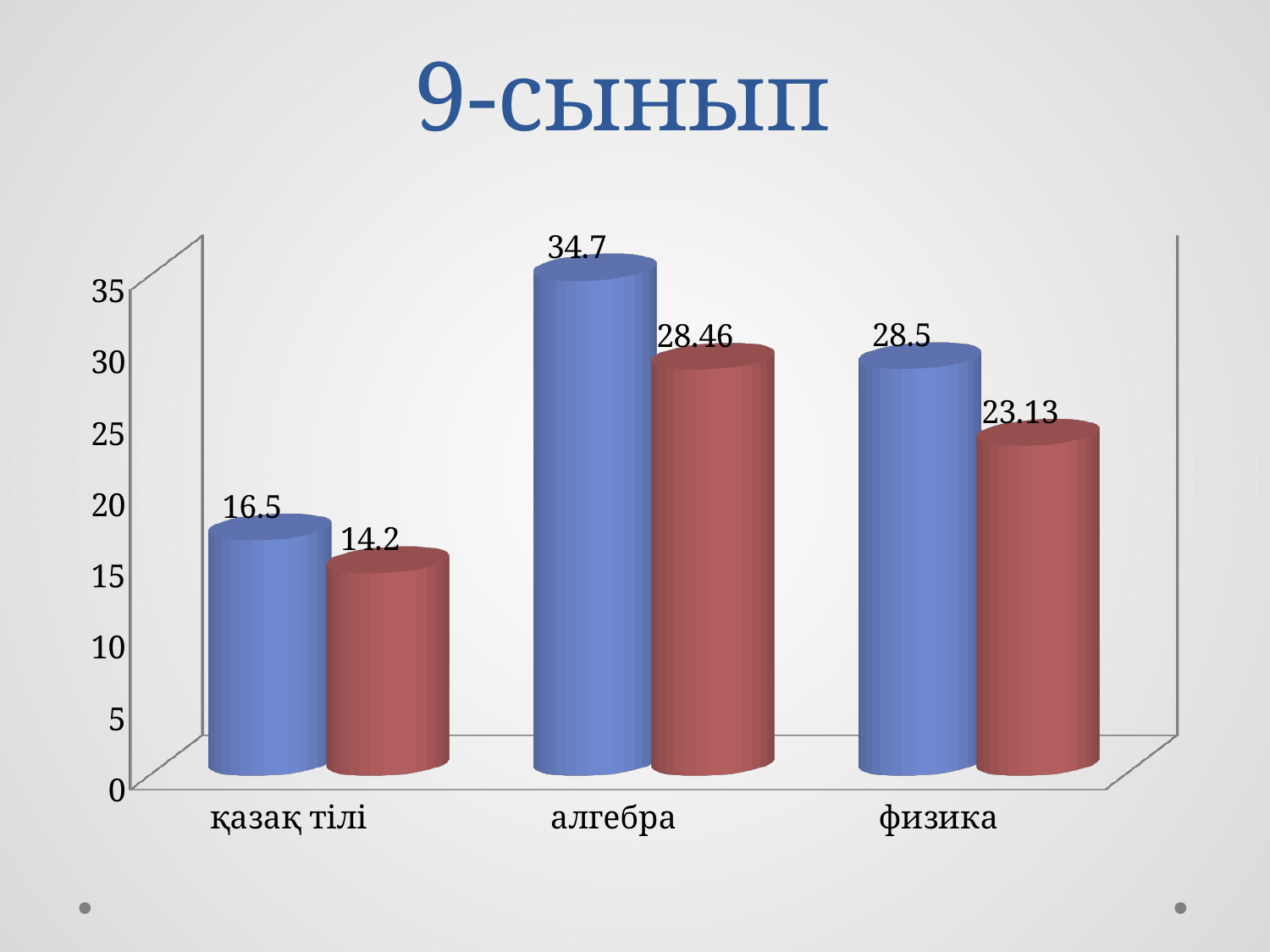
What is the value of the red bar for физика? 23.13 Which is larger: the red bar for алгебра or the blue bar for физика? the blue bar for физика How many categories are shown on the x axis? 3 What is the difference between the blue bars for физика and қазақ тілі? 12 What is the value of the blue bar for физика? 28.5 What is the difference between the blue and red bars for алгебра? 6.24 What is the value of the red bar for қазақ тілі? 14.2 Which category has the lowest red bar? қазақ тілі What kind of chart is shown on the slide? bar chart Which category has the highest blue bar? алгебра What is the title of the slide? 9-сынып What is the value of the blue bar for алгебра? 34.7